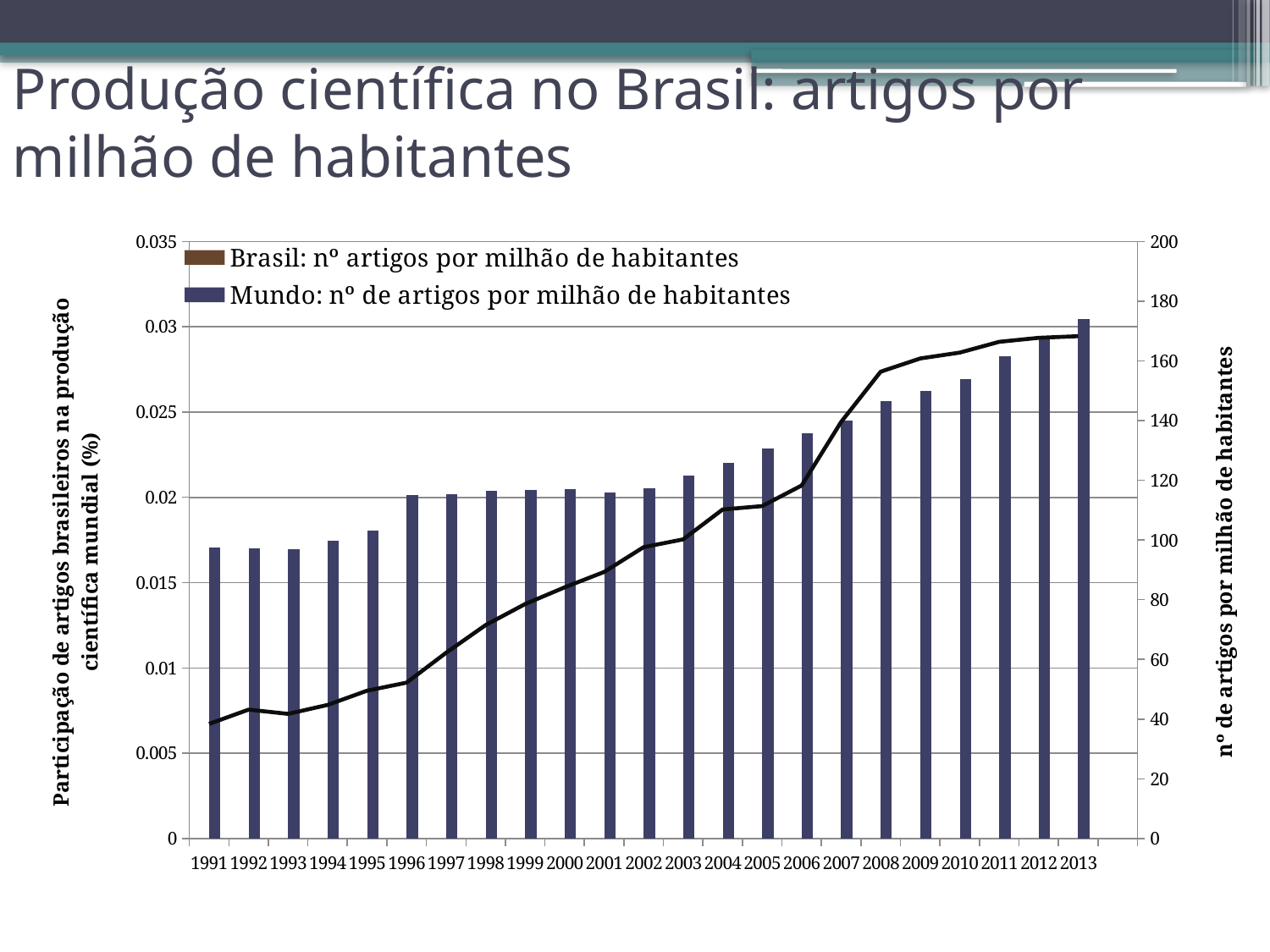
What is the first year shown on the x axis? 1991 On the right axis, is the bar value for 2005 greater or less than 120? greater Which bar is taller, 2000 or 2008? 2008 On the right axis, is the bar value for 1991 greater or less than 80? greater Which year has the tallest bar? 2013 Which bar is taller, 1991 or 2013? 2013 What kind of chart is shown on the slide? bar chart with a line What is the label of the right vertical axis? nº de artigos por milhão de habitantes How many series does the legend list? 2 Do the bar values generally rise or fall from 1991 to 2013? rise On the right axis, is the bar value for 2013 greater or less than 160? greater How many years are shown along the x axis? 23